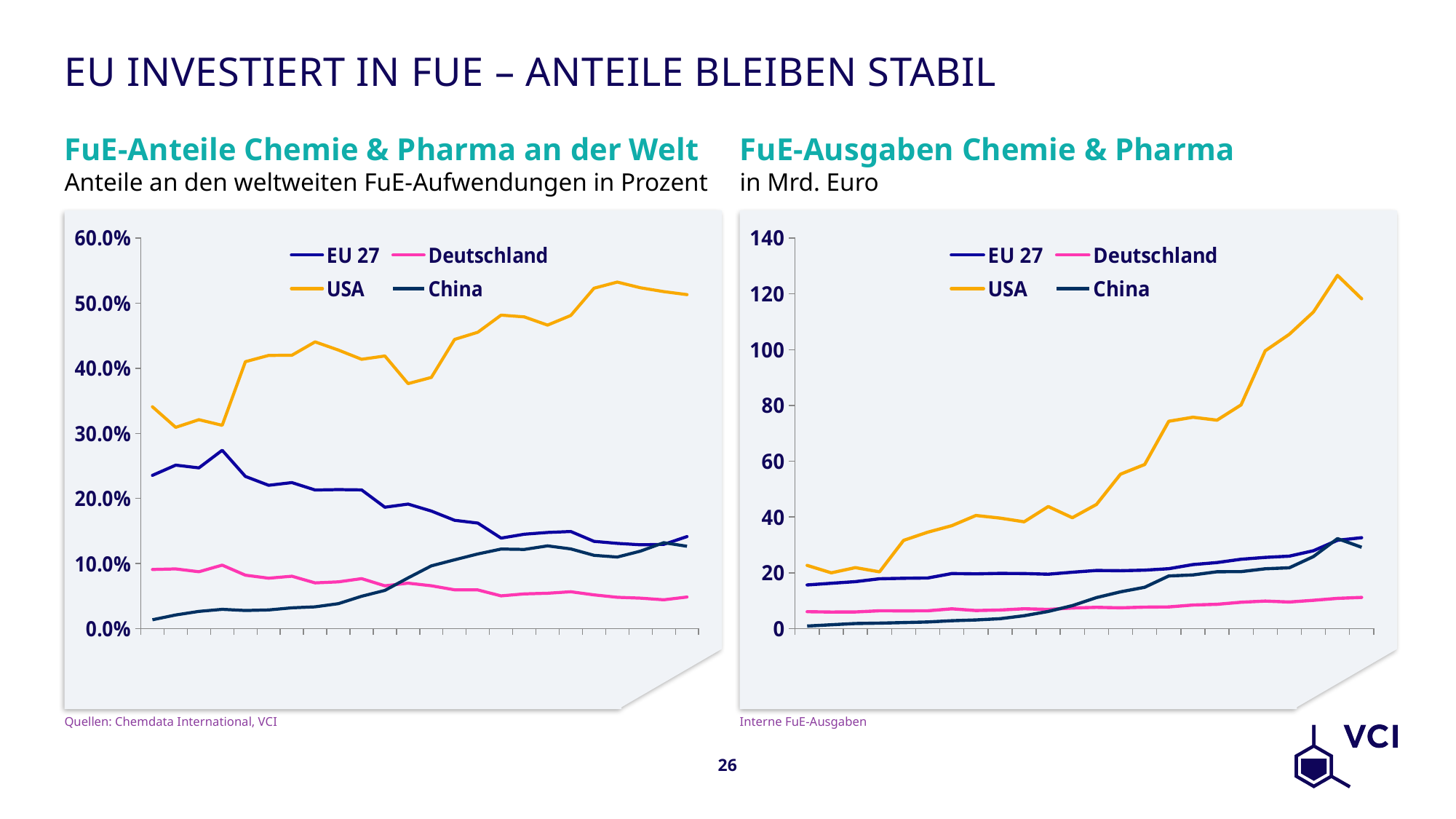
In the left chart 'FuE-Anteile Chemie & Pharma an der Welt', does the USA line rise or fall overall along the x axis? Rises How many series does the legend of the left chart 'FuE-Anteile Chemie & Pharma an der Welt' list? 4 How many series does the legend of the right chart 'FuE-Ausgaben Chemie & Pharma' list? 4 In the right chart 'FuE-Ausgaben Chemie & Pharma', which is larger at the right end of the chart: EU 27 or Deutschland? EU 27 In the left chart 'FuE-Anteile Chemie & Pharma an der Welt', does the EU 27 line rise or fall overall along the x axis? Falls In the left chart 'FuE-Anteile Chemie & Pharma an der Welt', which series has the lowest share at the left end of the chart? China In the right chart 'FuE-Ausgaben Chemie & Pharma', does the China line rise or fall overall along the x axis? Rises In the right chart 'FuE-Ausgaben Chemie & Pharma', is the peak value of the USA line greater or less than 120? greater In the right chart 'FuE-Ausgaben Chemie & Pharma', is the final value of the Deutschland line greater or less than 20? less In the left chart 'FuE-Anteile Chemie & Pharma an der Welt', is the final value of the USA line greater or less than 40.0%? greater In the left chart 'FuE-Anteile Chemie & Pharma an der Welt', which series has the highest share at the right end of the chart? USA What kind of chart is the left chart, 'FuE-Anteile Chemie & Pharma an der Welt'? Line chart